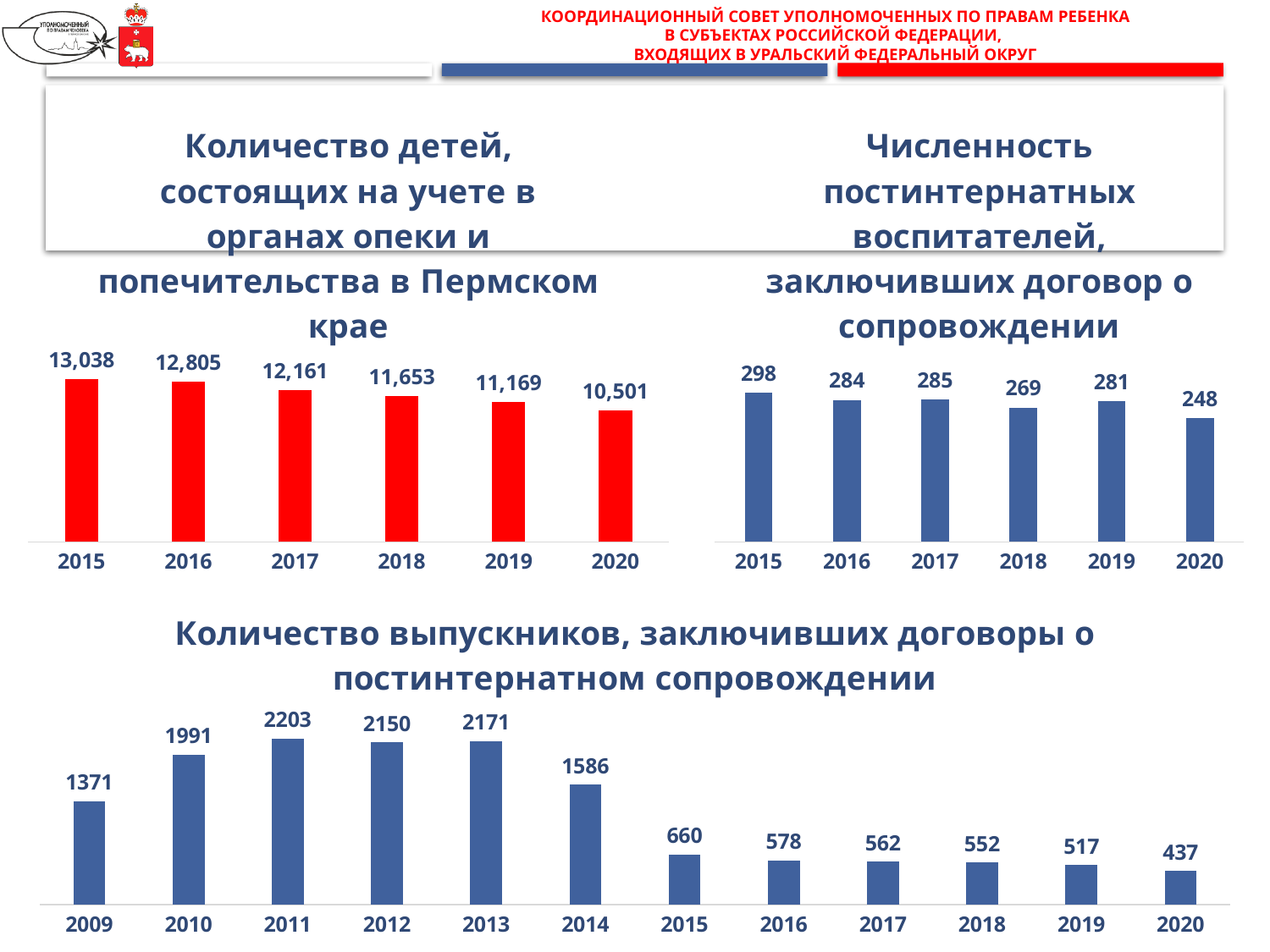
In the top-left chart, which year has the lowest value? 2020 In the bottom chart (Количество выпускников, заключивших договоры о постинтернатном сопровождении), what is the value for 2014? 1586 In the bottom chart, what is the difference between the 2013 and 2014 values? 585 In the top-left chart (Количество детей, состоящих на учете в органах опеки и попечительства в Пермском крае), what is the value for 2017? 12,161 In the top-right chart, which is larger: the value for 2019 or the value for 2020? 2019 In the top-right chart, which year has the highest value? 2015 In the top-right chart, how many years are shown? 6 In the bottom chart, which year has the highest value? 2011 In the top-left chart, what is the difference between the 2015 and 2020 values? 2,537 What type of chart is the bottom chart? bar chart In the top-right chart (Численность постинтернатных воспитателей, заключивших договор о сопровождении), what is the value for 2018? 269 In the top-left chart, do the values rise or fall from 2015 to 2020? fall